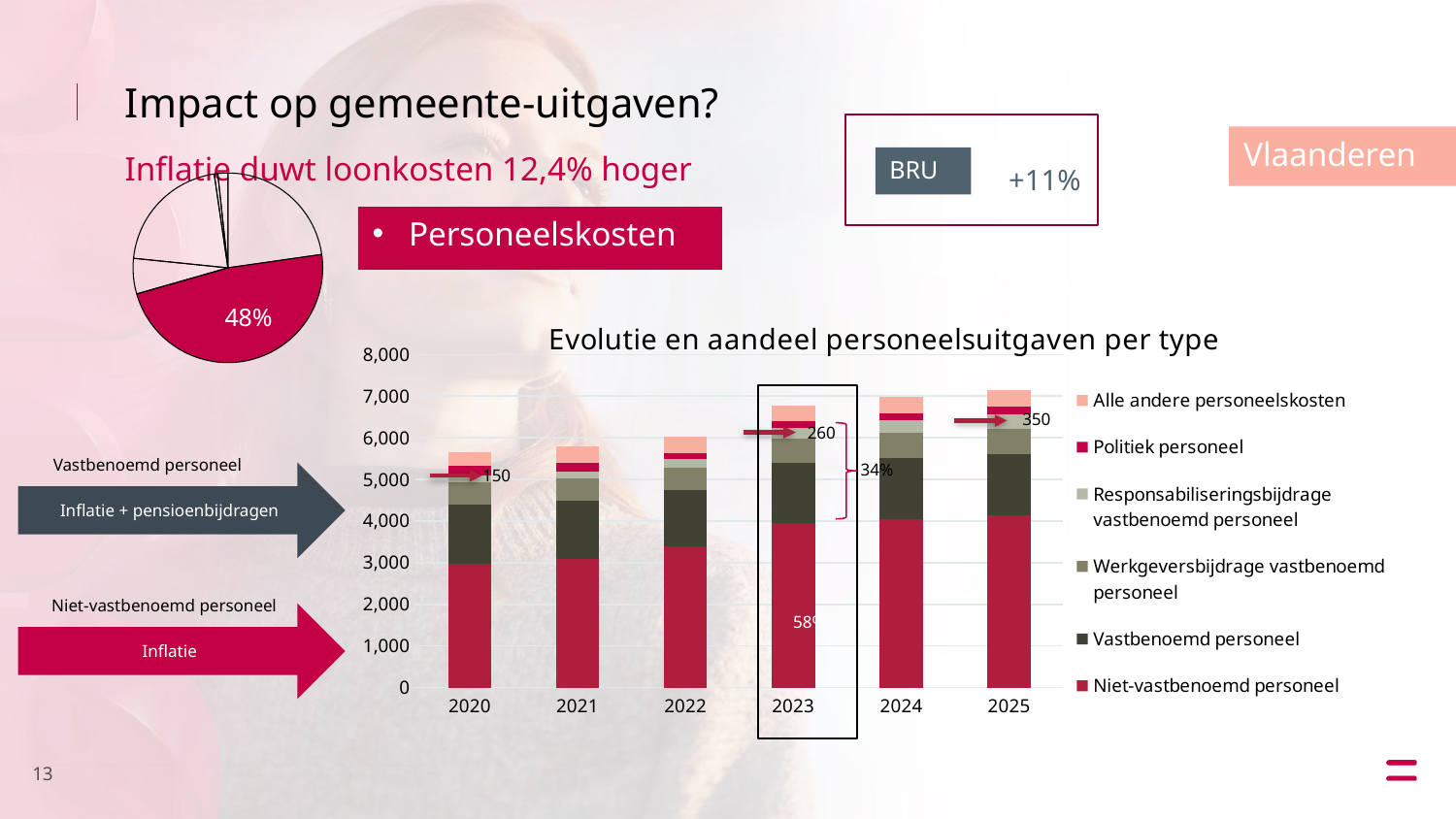
What type of chart is 'Evolutie en aandeel personeelsuitgaven per type'? Stacked bar chart In the 'Evolutie en aandeel personeelsuitgaven per type' chart, do the total personnel expenses rise or fall from 2020 to 2025? Rise In the 'Evolutie en aandeel personeelsuitgaven per type' chart, which year has the larger total stacked value, 2020 or 2025? 2025 How many series does the legend of the 'Evolutie en aandeel personeelsuitgaven per type' chart list? 6 In the 'Evolutie en aandeel personeelsuitgaven per type' chart, is the Niet-vastbenoemd personeel value for 2025 greater or less than 3,000? greater What type of chart is the small chart at the top left of the slide showing 48%? Pie chart In the 'Evolutie en aandeel personeelsuitgaven per type' chart, is the total stacked value for 2025 greater or less than 7,000? greater In the 'Evolutie en aandeel personeelsuitgaven per type' chart, which series is at the bottom of each stacked bar? Niet-vastbenoemd personeel How many years are shown on the x axis of the 'Evolutie en aandeel personeelsuitgaven per type' chart? 6 What percentage is labelled on the largest slice of the pie chart at the top left of the slide? 48% In the 'Evolutie en aandeel personeelsuitgaven per type' chart, is the Niet-vastbenoemd personeel value for 2020 greater or less than 4,000? less